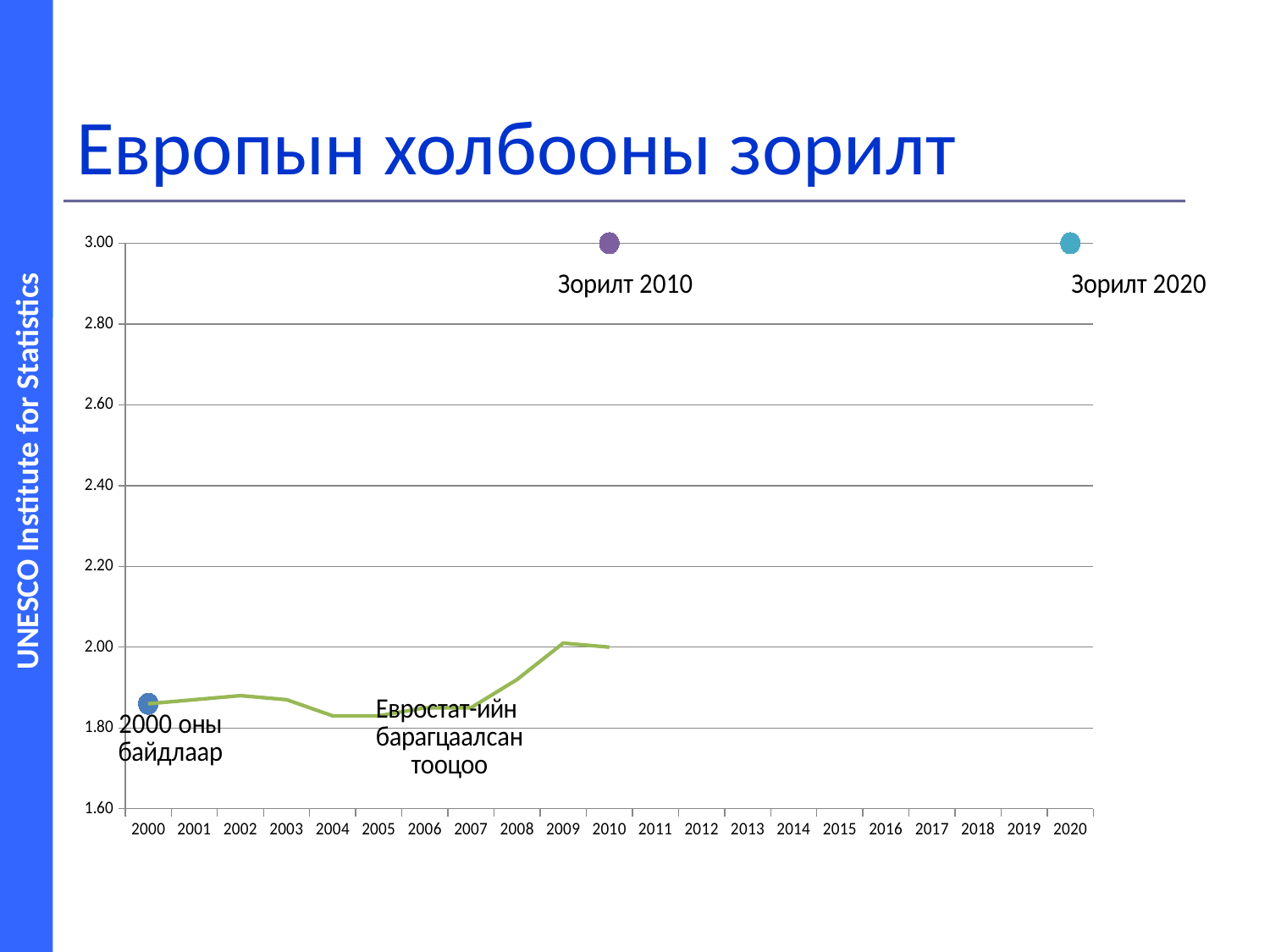
Which is larger, the green line's value in 2009 or in 2004? 2009 Is the value of the green line in 2009 greater or less than 2.20? less Which is larger, the Зорилт 2010 point or the green line's value in 2000? Зорилт 2010 What is the title of the slide chart? Европын холбооны зорилт Is the value of the green line in 2004 greater or less than 2.00? less What value does the point labelled Зорилт 2020 sit at? 3.00 Does the green line rise or fall between 2007 and 2009? rise What value does the point labelled Зорилт 2010 sit at? 3.00 What is the lowest value shown on the y axis? 1.60 How many years are labelled on the x axis? 21 Is the value of the green line in 2000 greater or less than 2.00? less What kind of chart is shown on the slide? line chart